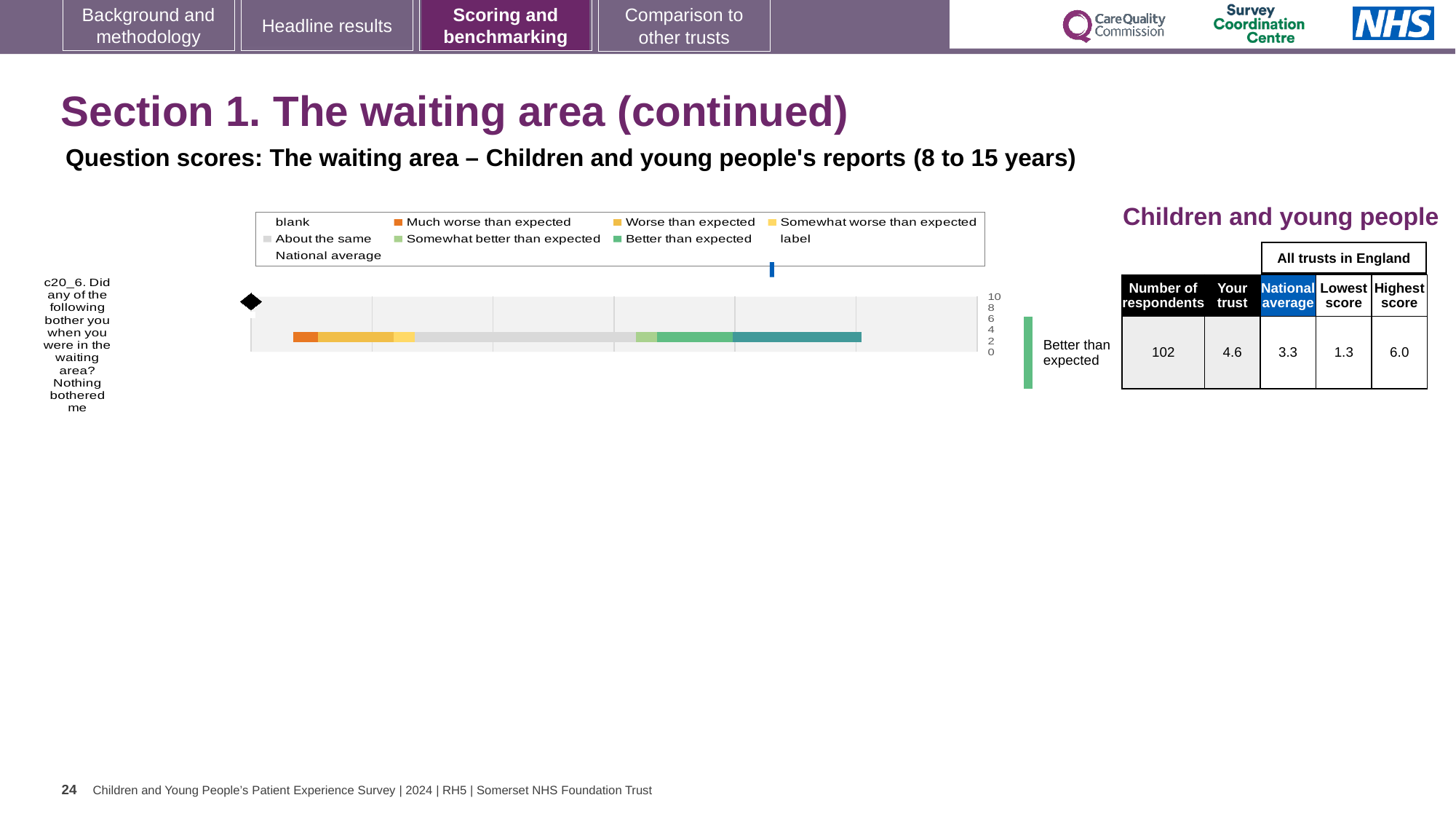
What is the difference between the 'Your trust' score and the national average for question c20_6? 1.3 Which legend entry is shown in orange in the bar chart? Much worse than expected In the table next to the chart, what is the highest score among all trusts in England for question c20_6? 6.0 In the table next to the chart, how many respondents answered question c20_6? 102 How many survey questions (categories) are plotted in the bar chart? 1 Which is larger for question c20_6: the 'Your trust' score or the national average? Your trust In the table next to the chart, what is the national average score for question c20_6? 3.3 What rating label is shown to the right of the bar for question c20_6? Better than expected What kind of chart is shown on the slide? bar chart Which question is plotted in the bar chart? c20_6. Did any of the following bother you when you were in the waiting area? Nothing bothered me In the table next to the chart, what is the 'Your trust' score for question c20_6? 4.6 In the table next to the chart, what is the lowest score among all trusts in England for question c20_6? 1.3